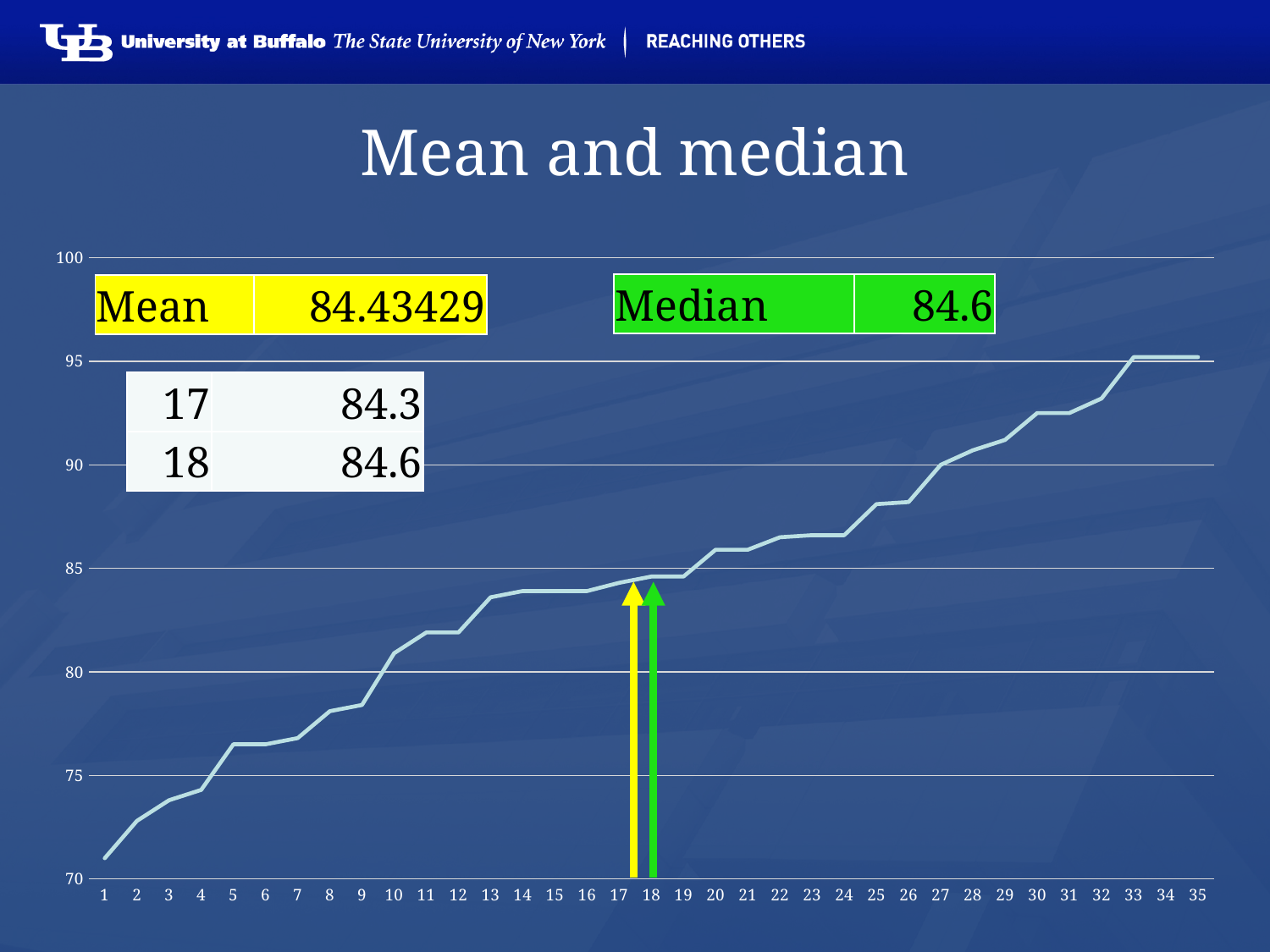
What is the value for point 17? 84.3 How many points are plotted along the x axis? 35 Which point has the lowest value? 1 What kind of chart is shown on the slide? line chart What is the difference between the values for points 18 and 17? 0.3 Is the value for point 1 greater or less than 75? less What is the value for point 18? 84.6 What is the title of the slide? Mean and median Is the value for point 24 greater or less than 90? less Do the values rise or fall as you move from point 1 to point 35? rise What mean value is shown in the yellow box? 84.43429 Is the value for point 27 greater or less than 85? greater